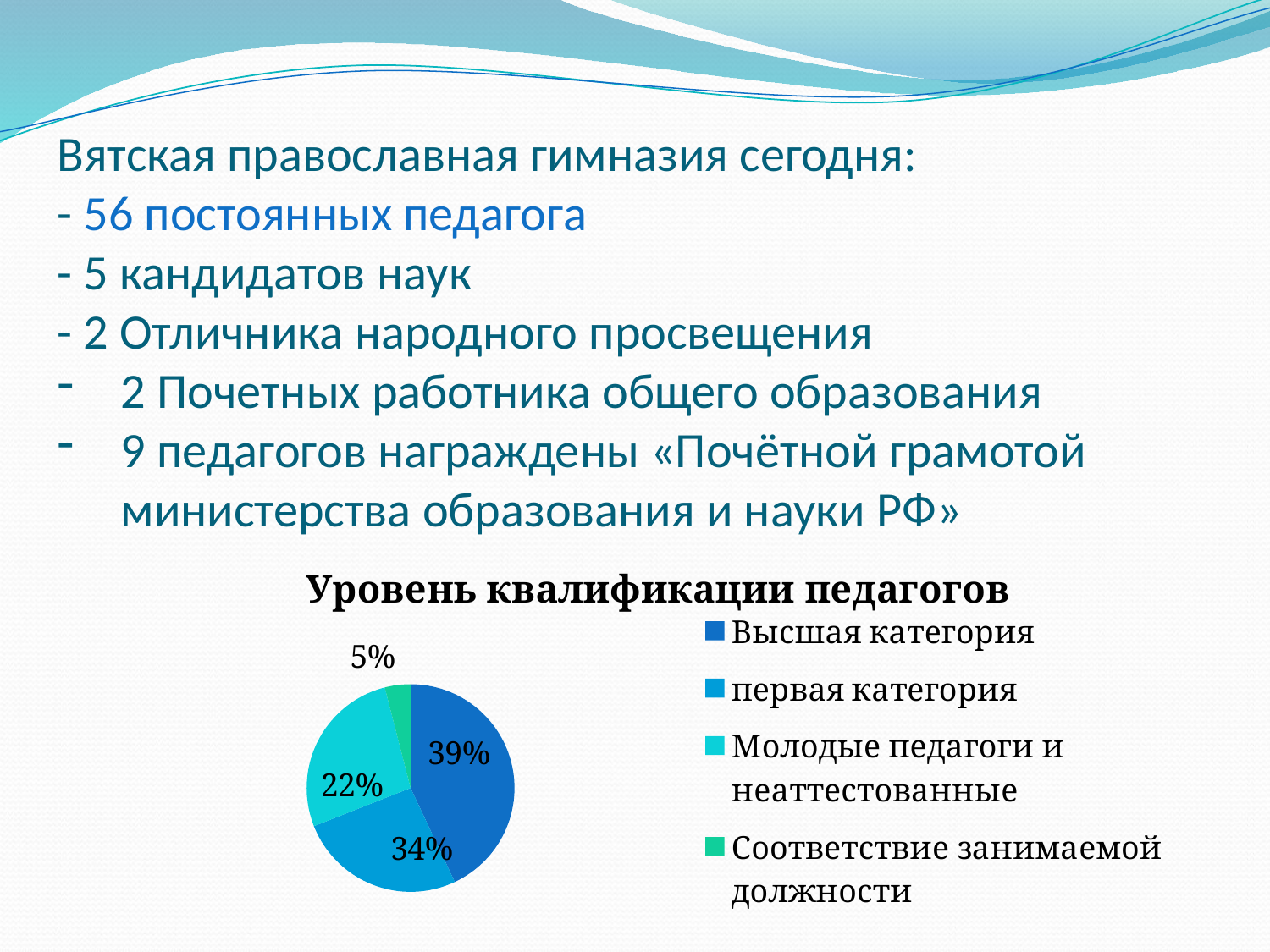
What share of the pie is "первая категория"? 34% Which is larger: the share for "первая категория" or for "Молодые педагоги и неаттестованные"? первая категория Which category has the largest slice of the pie? Высшая категория How many slices does the pie chart have? 4 What is the difference in percentage points between "Высшая категория" and "первая категория"? 5 What share of the pie is "Молодые педагоги и неаттестованные"? 22% What is the title of the chart? Уровень квалификации педагогов How many entries does the legend list? 4 What kind of chart is shown on the slide? pie chart Which category has the smallest slice of the pie? Соответствие занимаемой должности What share of the pie is "Соответствие занимаемой должности"? 5%